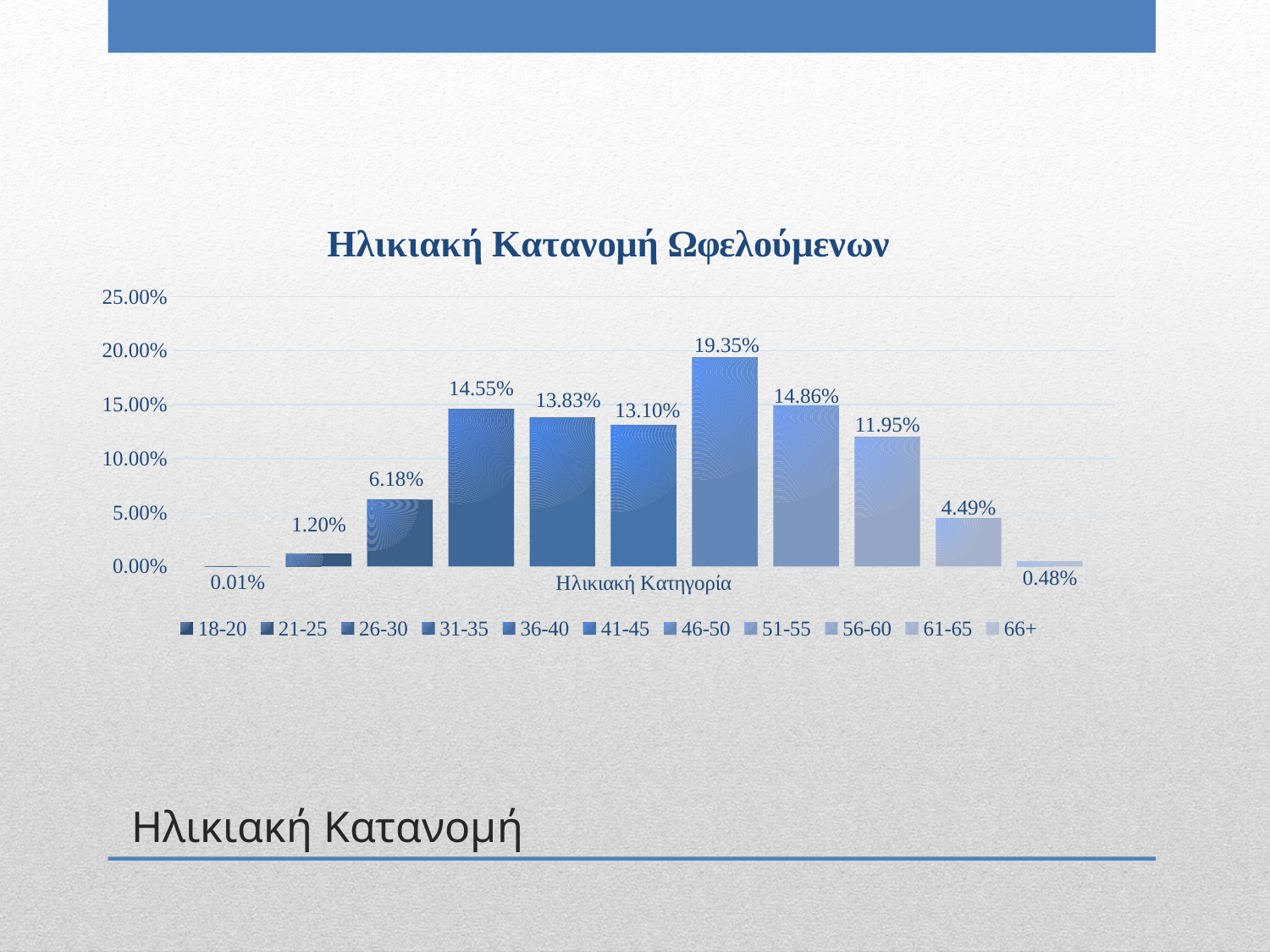
How many age groups are plotted in the chart? 11 Which age group has the lowest value? 18-20 Which age group has the highest value? 46-50 What is the value for the 66+ age group? 0.48% What is the value for the 46-50 age group? 19.35% What is the value for the 26-30 age group? 6.18% What is the title of the chart? Ηλικιακή Κατανομή Ωφελούμενων Which is larger, the value for 31-35 or the value for 36-40? 31-35 Is the value for 56-60 greater or less than 10.00%? greater What is the difference between the values for 46-50 and 51-55? 4.49% How many entries does the legend list? 11 What kind of chart is shown on the slide? bar chart